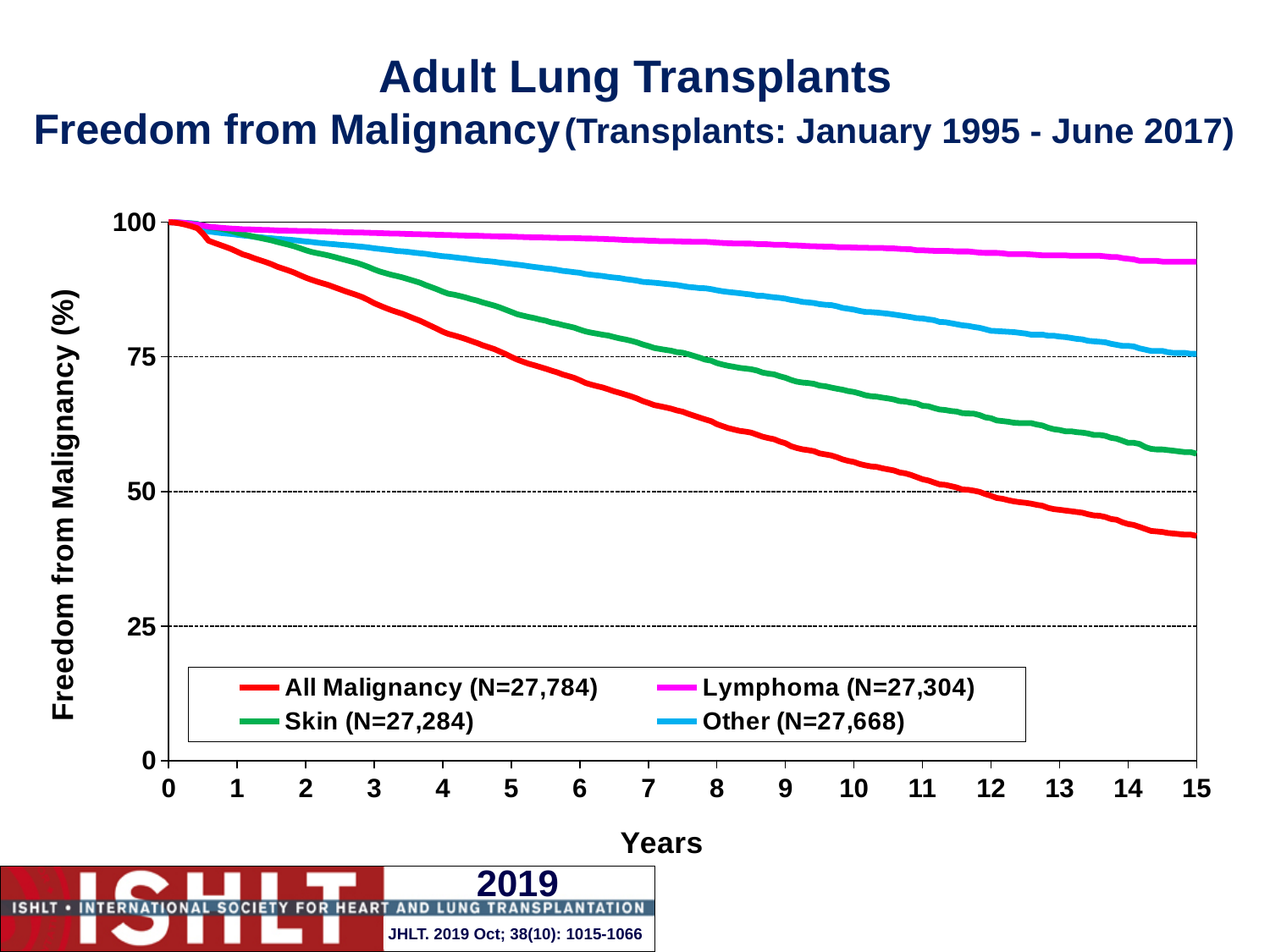
Is the value for Other at 10 years greater or less than 75? greater Do the values for All Malignancy rise or fall as years increase? fall At 10 years, which is larger: the value for Skin or the value for Other? Other How many series does the legend list? 4 Is the value for Lymphoma at 15 years greater or less than 75? greater What kind of chart is shown on the slide? line chart Which series has the highest freedom from malignancy at 15 years? Lymphoma (N=27,304) What is the label of the x axis? Years Is the value for Skin at 15 years greater or less than 50? greater What is the N shown in the legend for the Skin series? 27,284 Which series has the lowest freedom from malignancy at 15 years? All Malignancy (N=27,784)